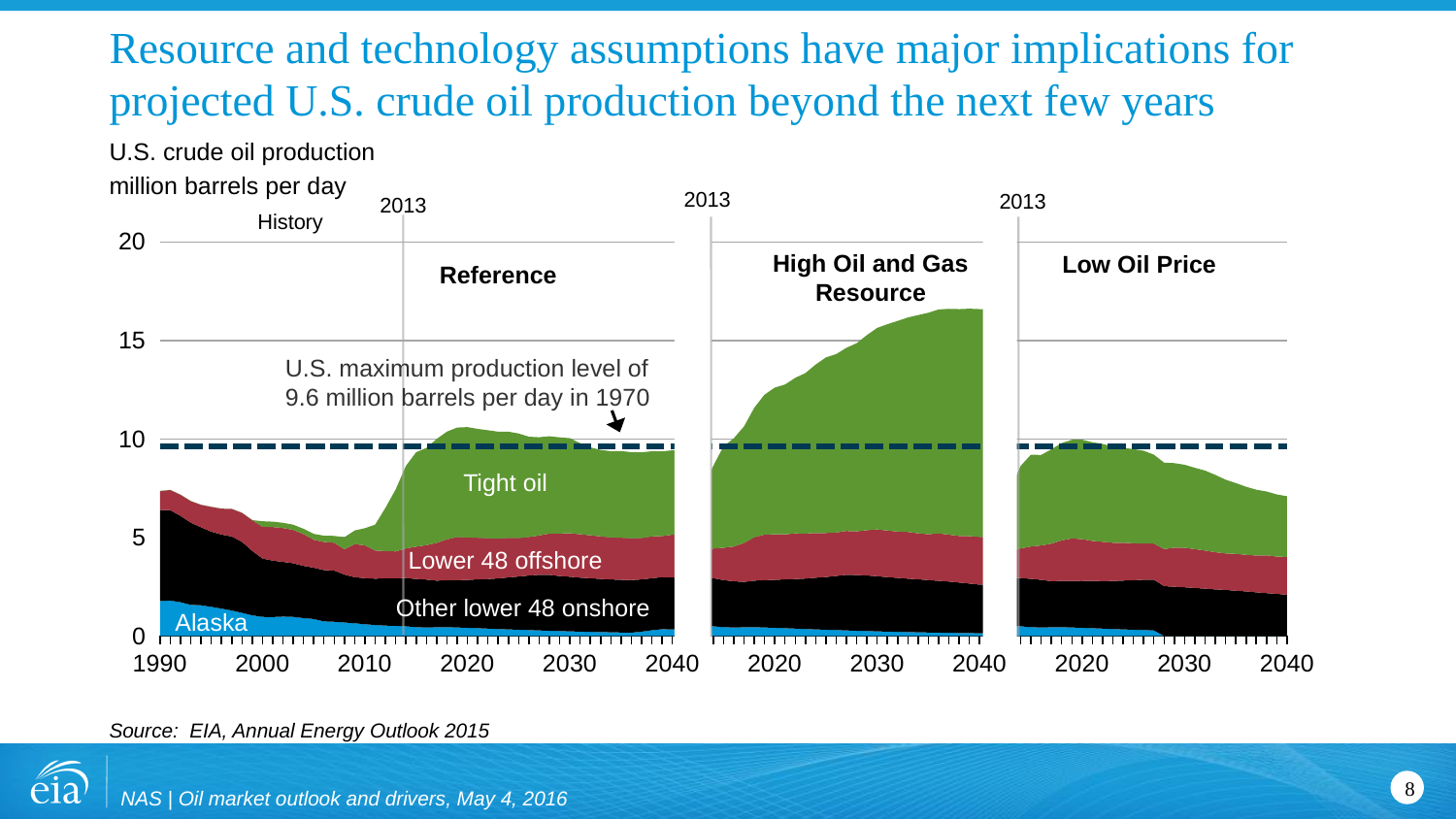
According to the annotation on the Reference chart, what was the U.S. maximum production level in 1970? 9.6 million barrels per day In the Low Oil Price chart, does total production rise or fall between 2020 and 2040? fall What kind of chart is used to show U.S. crude oil production on this slide? Stacked area chart In the Reference chart, is total production in 1990 greater or less than 10 million barrels per day? less Which four production categories are stacked in the charts? Alaska, Other lower 48 onshore, Lower 48 offshore, Tight oil Which of the three cases shows the lowest total production in 2040? Low Oil Price Which of the three cases shows the highest total production in 2040? High Oil and Gas Resource In the Low Oil Price chart, is total production in 2040 greater or less than 10 million barrels per day? less How many projection cases (chart panels) are shown on the slide? 3 Which case shows higher total production in 2040, High Oil and Gas Resource or Low Oil Price? High Oil and Gas Resource In the High Oil and Gas Resource chart, is total production in 2040 greater or less than 15 million barrels per day? greater In the High Oil and Gas Resource chart, does total production rise or fall between 2013 and 2040? rise